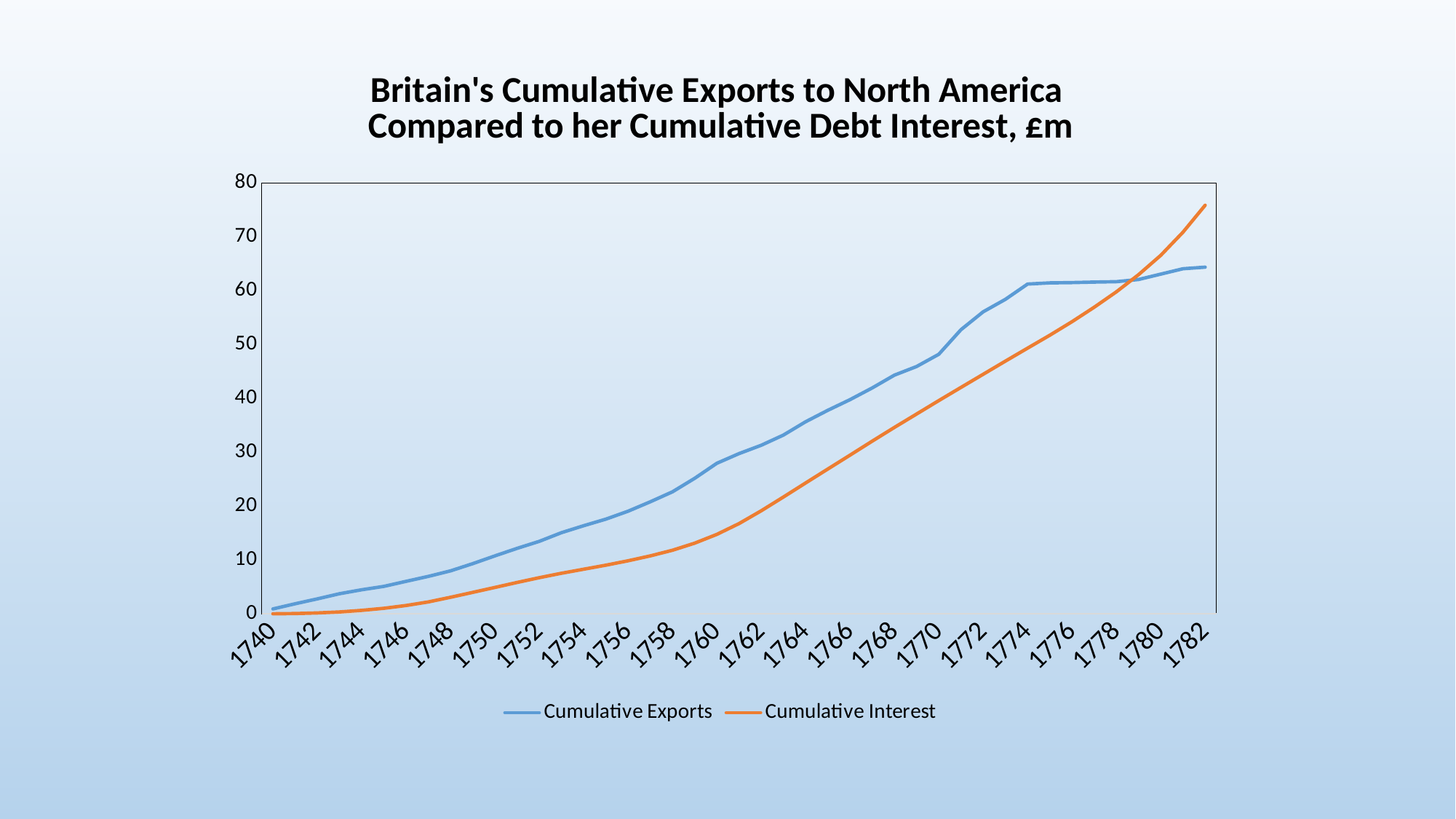
How many series does the legend list? 2 How many year labels are shown along the x axis? 22 Is the value for Cumulative Exports in 1782 greater or less than 70? less What kind of chart is shown on the slide? line chart Does the Cumulative Interest line rise or fall from 1740 to 1782? rise What is the title of the chart? Britain's Cumulative Exports to North America Compared to her Cumulative Debt Interest, £m Which colour is used for the Cumulative Interest line? orange Is the value for Cumulative Interest in 1760 greater or less than 20? less Is the value for Cumulative Exports in 1760 greater or less than 20? greater In 1770, which series has the larger value, Cumulative Exports or Cumulative Interest? Cumulative Exports In 1782, which series has the larger value, Cumulative Exports or Cumulative Interest? Cumulative Interest